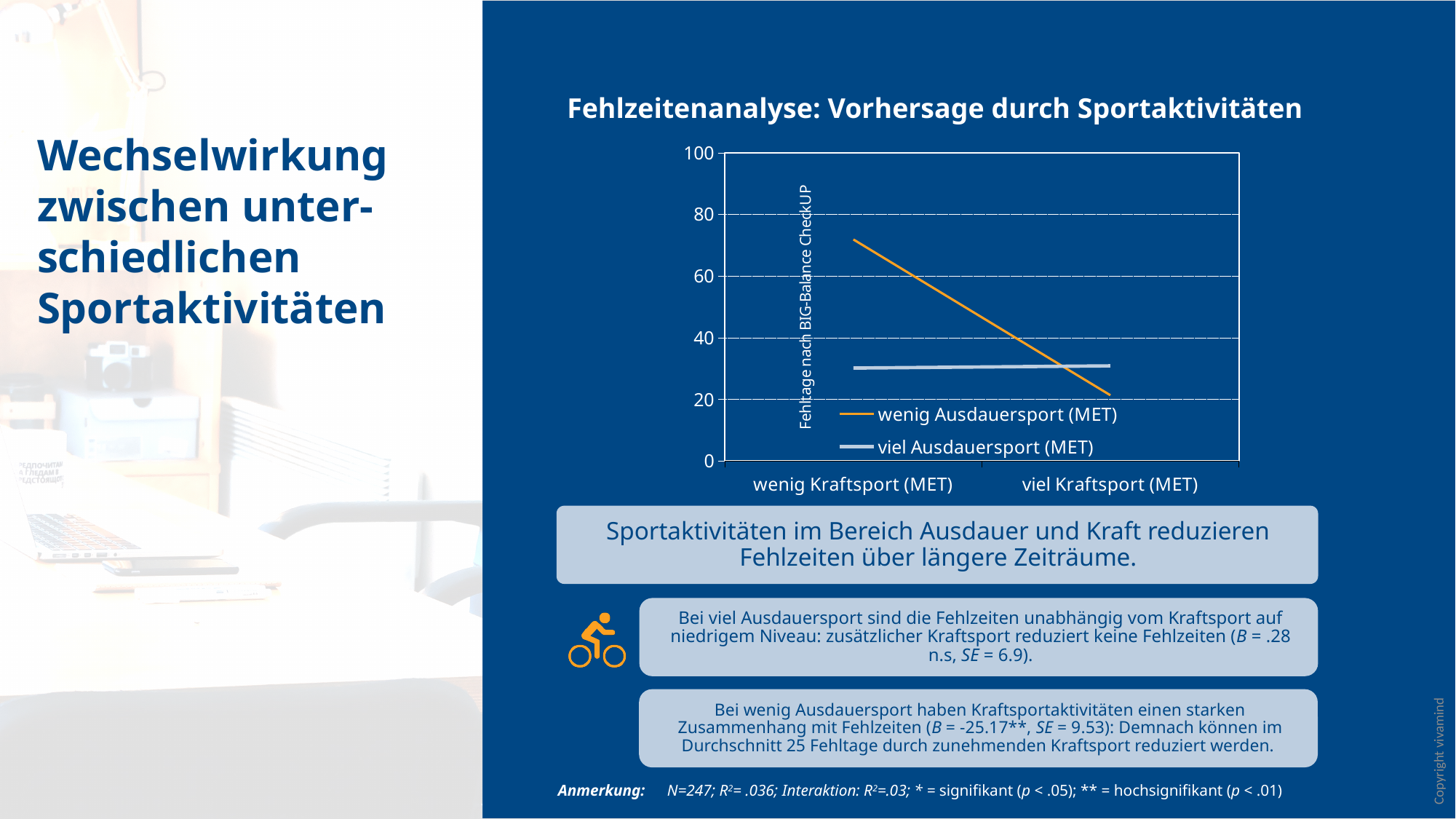
What kind of chart is shown on the slide? line chart At 'wenig Kraftsport (MET)', which series has the higher value: 'wenig Ausdauersport (MET)' or 'viel Ausdauersport (MET)'? wenig Ausdauersport (MET) How many categories are shown on the x axis of the chart? 2 Is the value for 'wenig Ausdauersport (MET)' at 'viel Kraftsport (MET)' greater or less than 40? less How many series does the chart's legend list? 2 Does the line for 'wenig Ausdauersport (MET)' rise or fall from 'wenig Kraftsport (MET)' to 'viel Kraftsport (MET)'? fall What is the title of the chart? Fehlzeitenanalyse: Vorhersage durch Sportaktivitäten Is the value for 'wenig Ausdauersport (MET)' at 'wenig Kraftsport (MET)' greater or less than 60? greater Is the value for 'viel Ausdauersport (MET)' at 'viel Kraftsport (MET)' greater or less than 20? greater At 'viel Kraftsport (MET)', which series has the lower value: 'wenig Ausdauersport (MET)' or 'viel Ausdauersport (MET)'? wenig Ausdauersport (MET) What is the label of the vertical axis? Fehltage nach BIG-Balance CheckUP